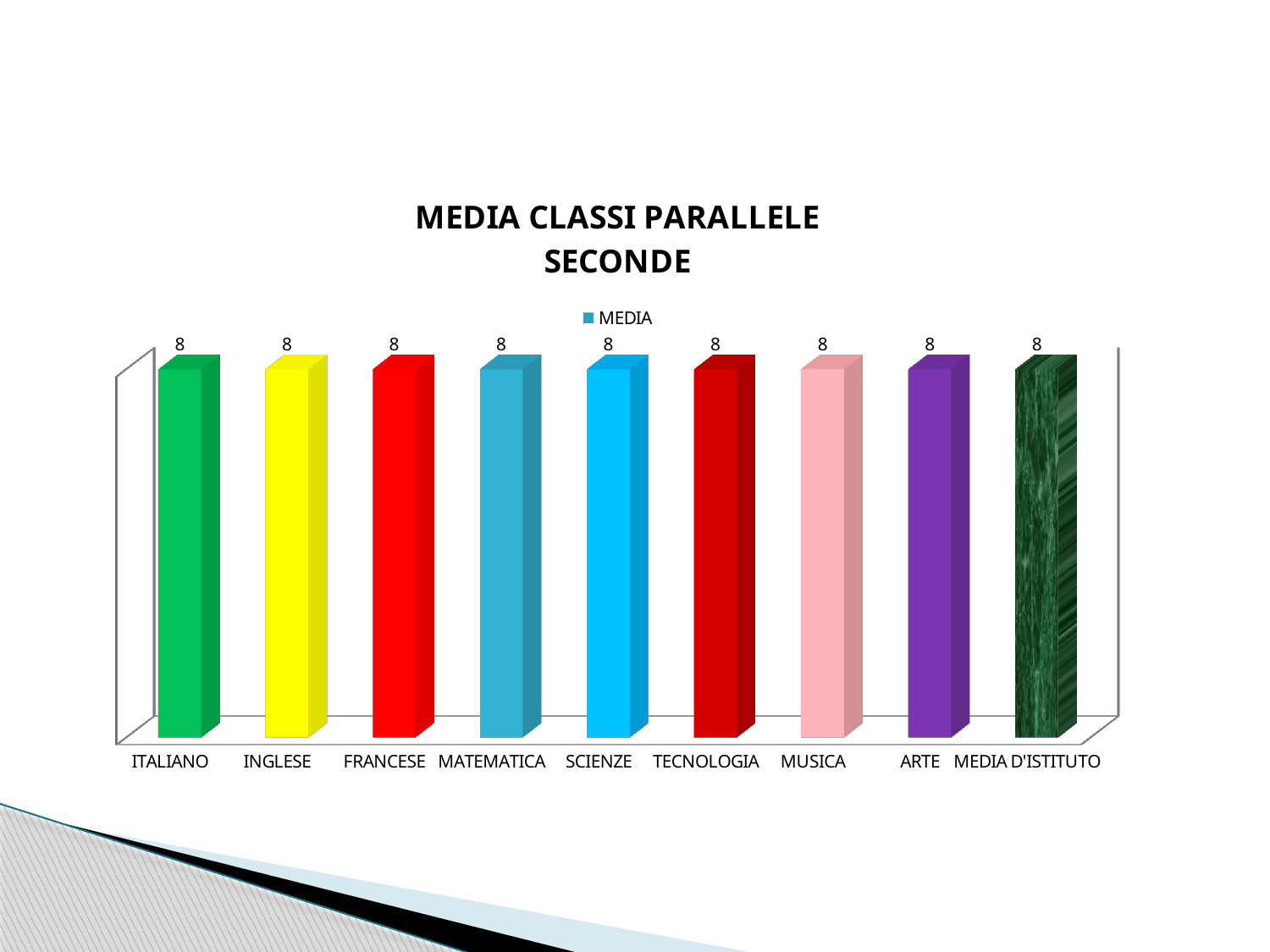
What is the value for MEDIA D'ISTITUTO? 8 What is the name of the series listed in the legend? MEDIA What is the title of the chart? MEDIA CLASSI PARALLELE SECONDE Do the values rise, fall, or stay the same across the categories from ITALIANO to MEDIA D'ISTITUTO? stay the same What is the value for ITALIANO? 8 What kind of chart is shown on the slide? bar chart What is the difference between the values for INGLESE and MUSICA? 0 What is the value for ARTE? 8 How many series does the legend list? 1 How many categories are shown on the x axis? 9 What is the value for TECNOLOGIA? 8 What is the value for MATEMATICA? 8